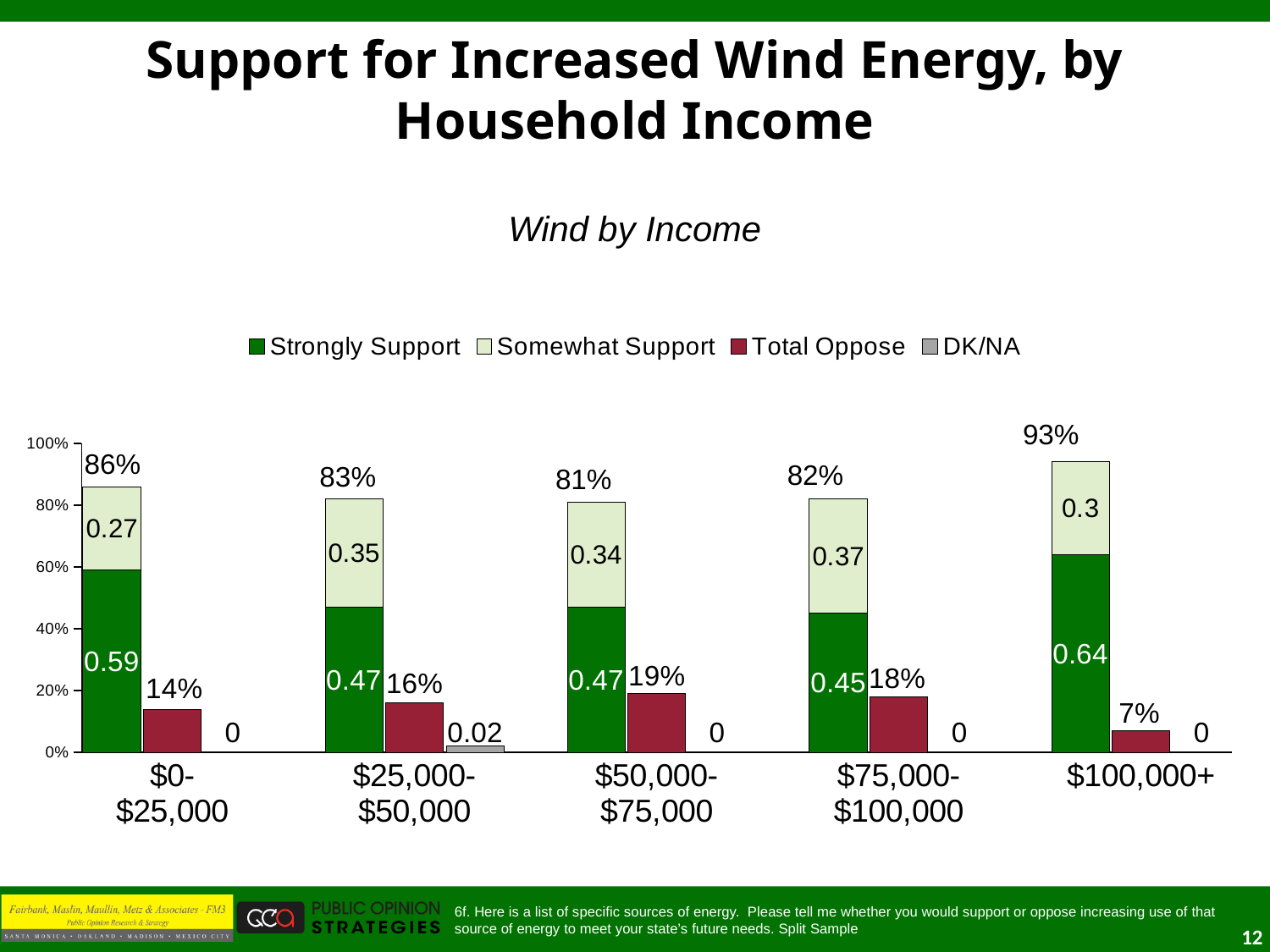
What is the DK/NA value for the $25,000-$50,000 income group? 0.02 What is the subtitle shown above the chart? Wind by Income Which income group has the lowest Total Oppose value? $100,000+ How many income categories are shown on the x axis? 5 What is the Somewhat Support value for the $75,000-$100,000 income group? 0.37 What kind of chart is shown on the slide? Stacked bar chart What is the Total Oppose value for the $50,000-$75,000 income group? 19% What is the Strongly Support value for the $100,000+ income group? 0.64 Which income group has the highest total support percentage shown above its stacked bar? $100,000+ Which is larger: the Strongly Support value for $0-$25,000 or for $75,000-$100,000? $0-$25,000 What is the difference between the total support for the $100,000+ group and the $50,000-$75,000 group? 12% How many series does the legend list? 4